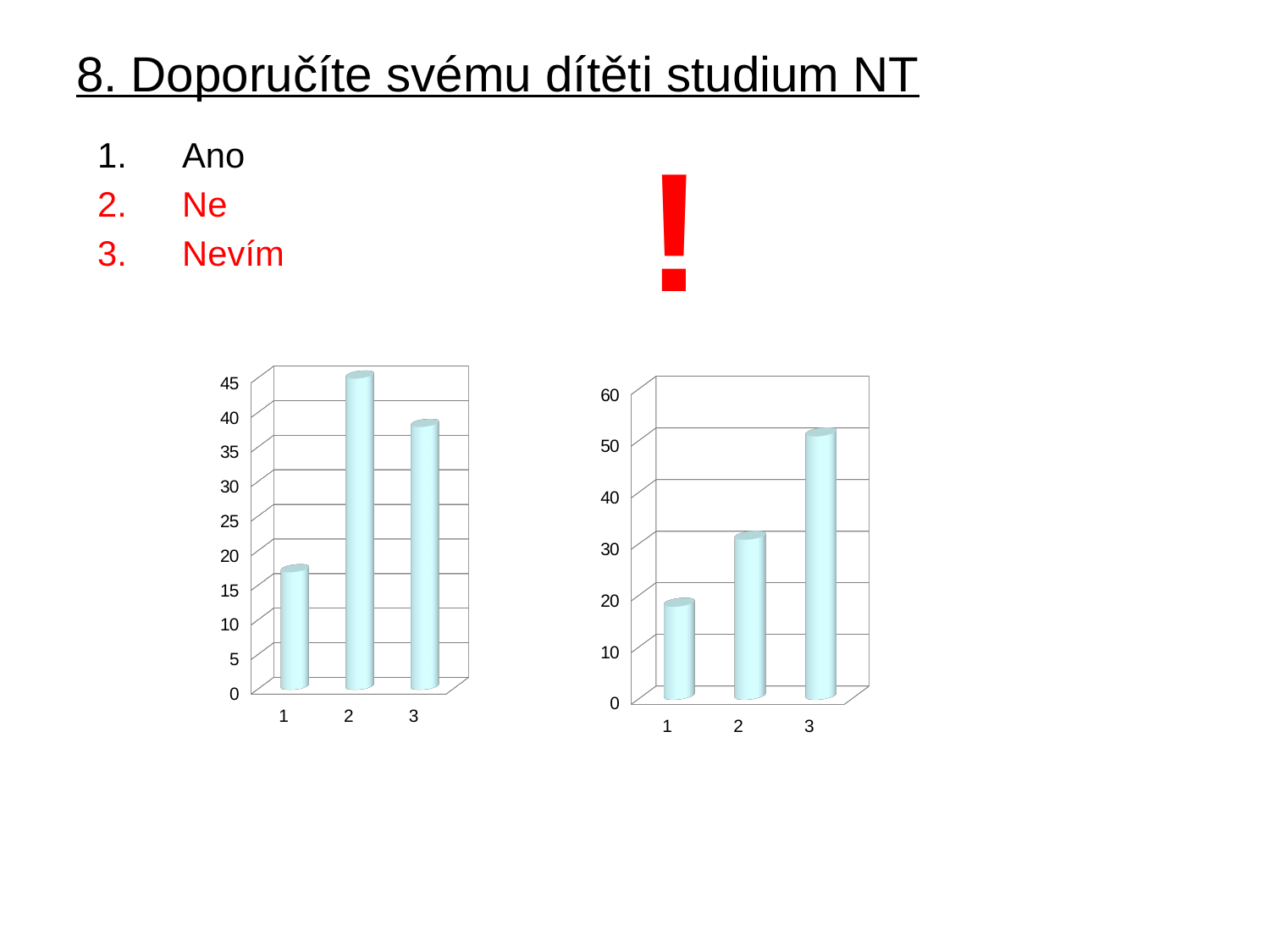
In the left chart, is the value for category 2 greater or less than 40? greater In the right chart, is the value for category 3 greater or less than 40? greater In the left chart, which category has the lowest bar? 1 In the left chart, which category has the highest bar? 2 How many bars does the left chart show? 3 In the left chart, is the value for category 1 greater or less than 20? less What kind of chart is the left chart on the slide? bar chart How many bars does the right chart show? 3 In the right chart, do the values rise or fall from category 1 to category 3? rise In the right chart, which category has the highest bar? 3 In the right chart, is the value for category 2 larger than the value for category 1? yes In the right chart, which category has the lowest bar? 1